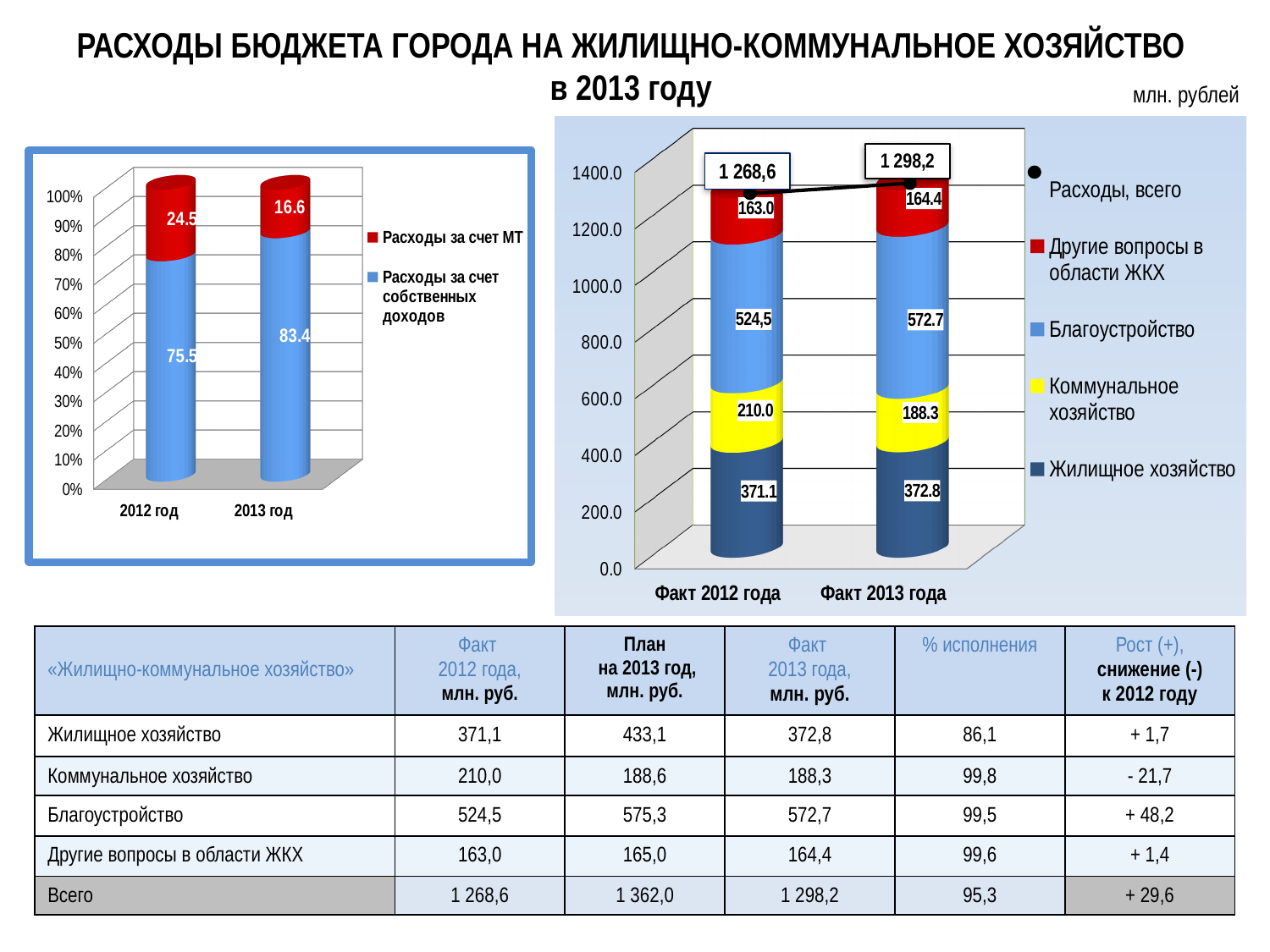
In the right chart, which segment is the largest in the Факт 2012 года bar? Благоустройство In the right chart, what is the difference between «Благоустройство» in Факт 2013 года and Факт 2012 года? 48.2 In the left chart, what is the value of «Расходы за счет МТ» for 2013 год? 16.6 In the left chart, how many series does the legend list? 2 In the right chart, which is larger: «Коммунальное хозяйство» in Факт 2012 года or in Факт 2013 года? Факт 2012 года In the left chart, what is the value of «Расходы за счет собственных доходов» for 2012 год? 75.5 What kind of chart is the right chart? stacked bar chart In the right chart, what is the total «Расходы, всего» for Факт 2013 года? 1 298,2 In the right chart, what is the value of «Благоустройство» for Факт 2013 года? 572.7 In the right chart, what is the value of «Коммунальное хозяйство» for Факт 2012 года? 210.0 In the right chart, which segment is the smallest in the Факт 2013 года bar? Другие вопросы в области ЖКХ In the left chart, does the share of «Расходы за счет МТ» rise or fall from 2012 год to 2013 год? fall